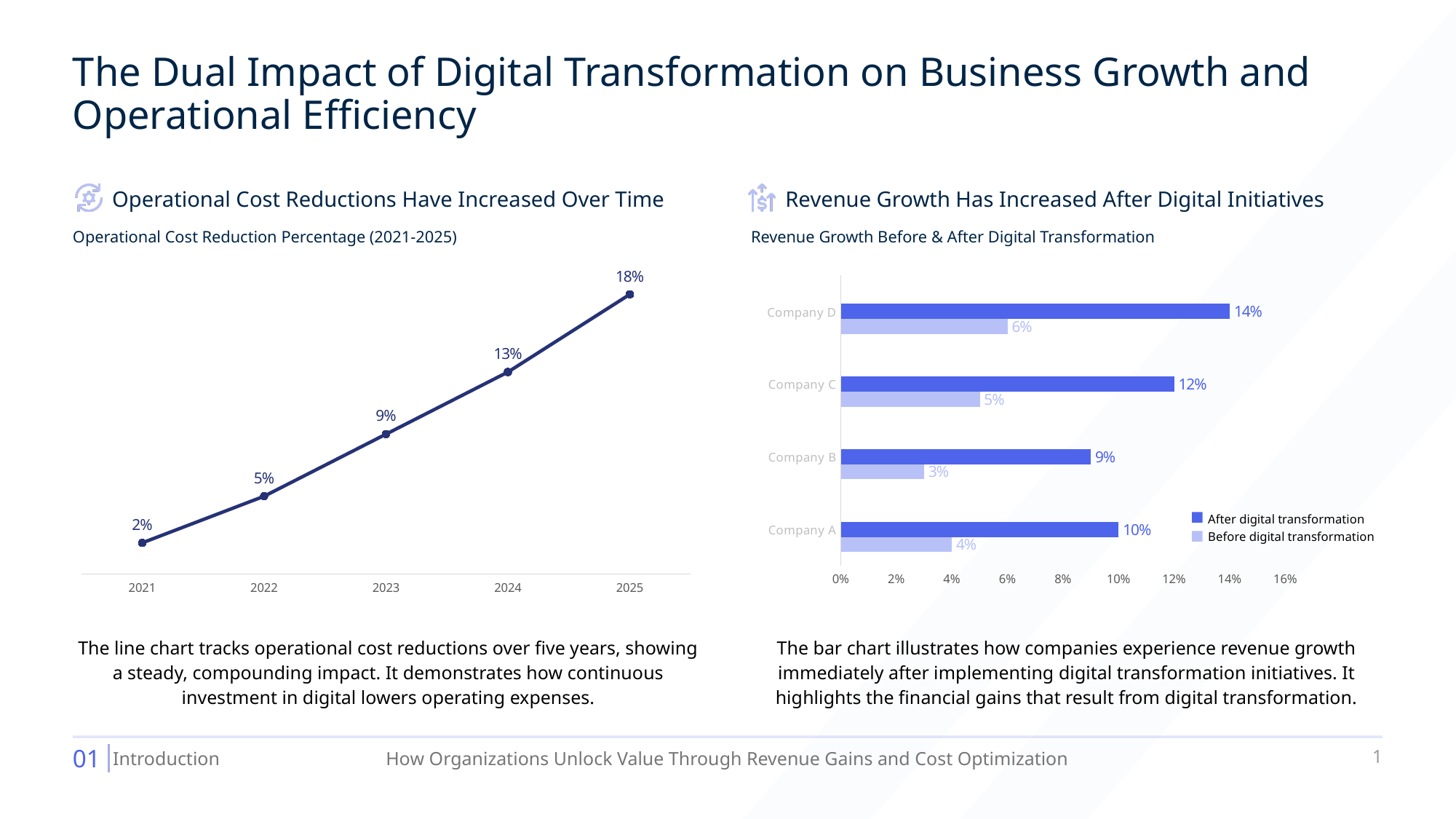
What kind of chart is the 'Operational Cost Reduction Percentage (2021-2025)' chart? line chart How many data points are plotted in the 'Operational Cost Reduction Percentage (2021-2025)' chart? 5 In the 'Revenue Growth Before & After Digital Transformation' chart, which is larger: Company A after digital transformation or Company B after digital transformation? Company A after digital transformation In the 'Revenue Growth Before & After Digital Transformation' chart, what is the difference between Company D's after and before digital transformation values? 8% In the 'Revenue Growth Before & After Digital Transformation' chart, what is the value for Company C after digital transformation? 12% In the 'Operational Cost Reduction Percentage (2021-2025)' chart, what is the difference between the 2025 and 2021 values? 16% In the 'Operational Cost Reduction Percentage (2021-2025)' chart, do the values rise or fall from 2021 to 2025? rise In the 'Operational Cost Reduction Percentage (2021-2025)' chart, what is the value for 2023? 9% In the 'Operational Cost Reduction Percentage (2021-2025)' chart, which year has the highest value? 2025 In the 'Revenue Growth Before & After Digital Transformation' chart, which company has the lowest value before digital transformation? Company B How many series does the legend list in the 'Revenue Growth Before & After Digital Transformation' chart? 2 What kind of chart is the 'Revenue Growth Before & After Digital Transformation' chart? bar chart